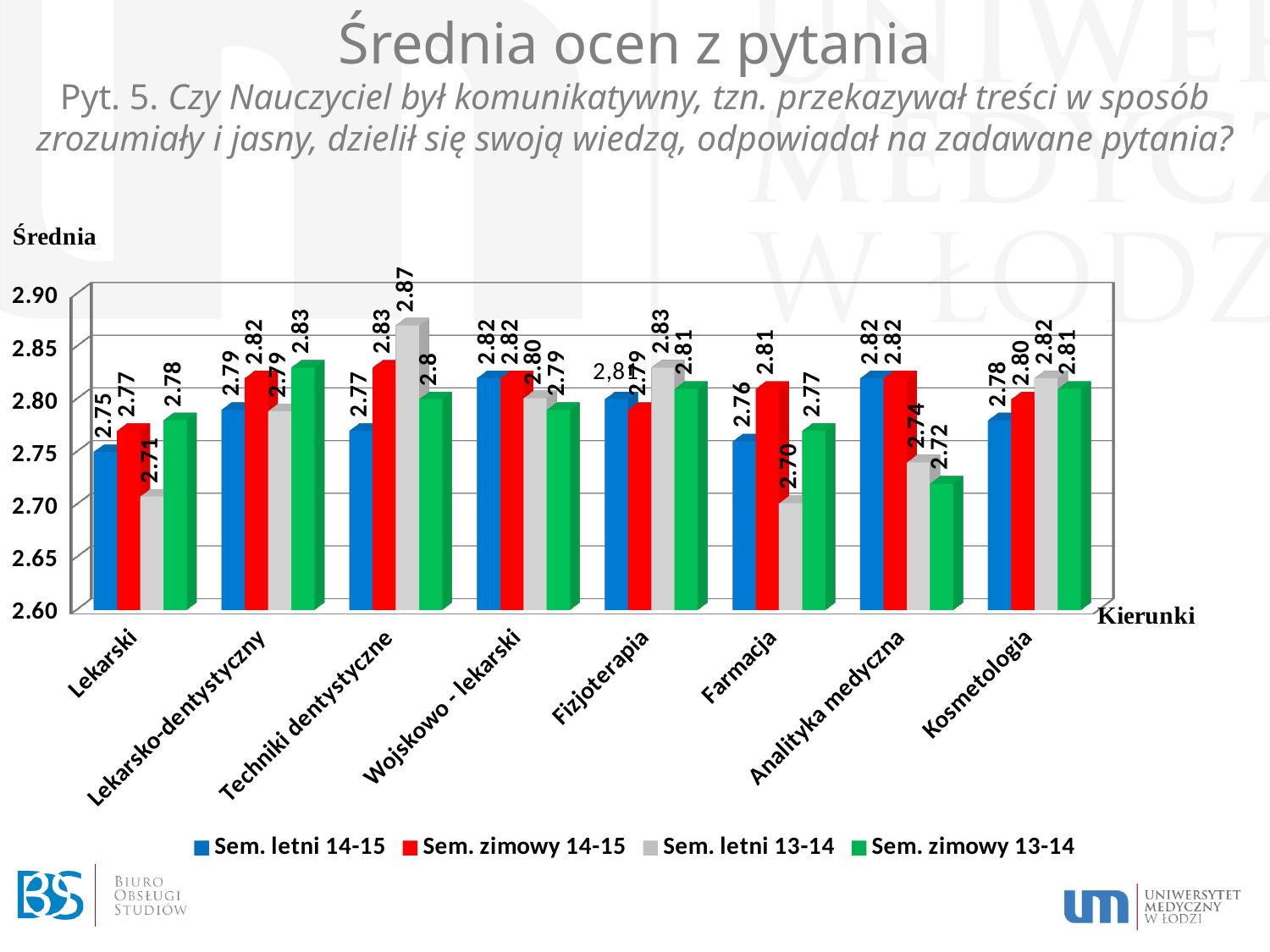
Which category has the highest value in the Sem. letni 13-14 series? Techniki dentystyczne What kind of chart is shown on the slide? Bar chart What is the value for Farmacja in the Sem. letni 13-14 series? 2.70 How many categories are shown on the x axis? 8 What is the value for Techniki dentystyczne in the Sem. letni 13-14 series? 2.87 What is the difference between the Sem. letni 13-14 value and the Sem. zimowy 13-14 value for Techniki dentystyczne? 0.07 Which is larger for Farmacja: the Sem. zimowy 14-15 value or the Sem. letni 13-14 value? Sem. zimowy 14-15 Which category has the lowest value in the Sem. letni 14-15 series? Lekarski What is the value for Analityka medyczna in the Sem. zimowy 13-14 series? 2.72 What is the value for Lekarski in the Sem. zimowy 13-14 series? 2.78 How many series does the legend list? 4 What is the label of the y axis? Średnia